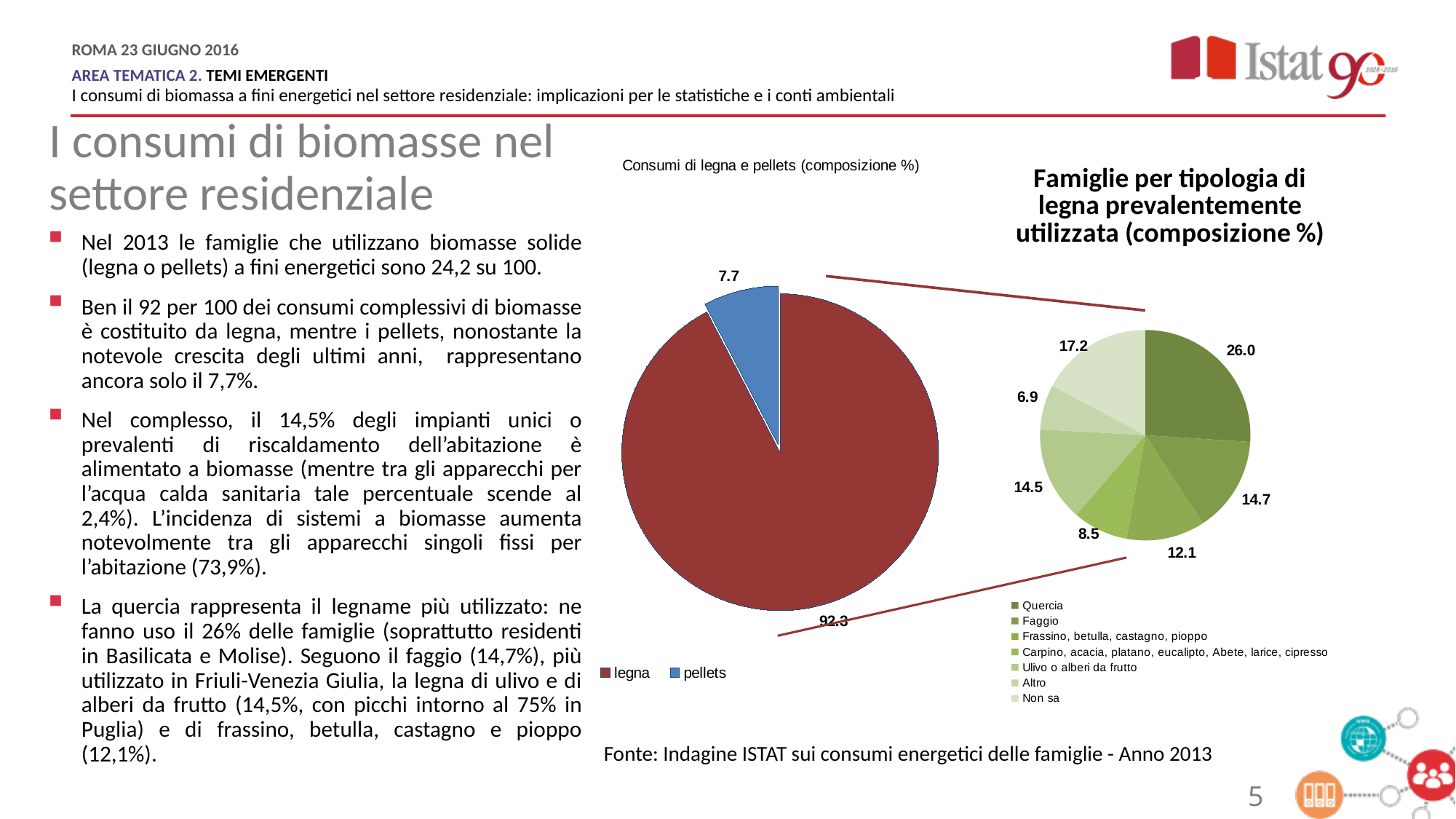
In the 'Famiglie per tipologia di legna prevalentemente utilizzata' pie chart, how many categories are shown? 7 In the 'Consumi di legna e pellets' pie chart, what is the value for legna? 92.3 How many series does the legend of the 'Consumi di legna e pellets' chart list? 2 In the 'Famiglie per tipologia di legna prevalentemente utilizzata' pie chart, which category has the smallest share? Altro In the 'Famiglie per tipologia di legna prevalentemente utilizzata' pie chart, what is the value for Quercia? 26.0 In the 'Famiglie per tipologia di legna prevalentemente utilizzata' pie chart, what is the difference between the Quercia and Frassino, betulla, castagno, pioppo values? 13.9 In the 'Consumi di legna e pellets' pie chart, what is the difference between the legna and pellets values? 84.6 In the 'Famiglie per tipologia di legna prevalentemente utilizzata' pie chart, what is the value for Non sa? 17.2 In the 'Famiglie per tipologia di legna prevalentemente utilizzata' pie chart, what is the value for Faggio? 14.7 In the 'Consumi di legna e pellets' pie chart, what is the value for pellets? 7.7 What type of chart is the 'Consumi di legna e pellets' chart? Pie chart In the 'Famiglie per tipologia di legna prevalentemente utilizzata' pie chart, which category has the largest share? Quercia